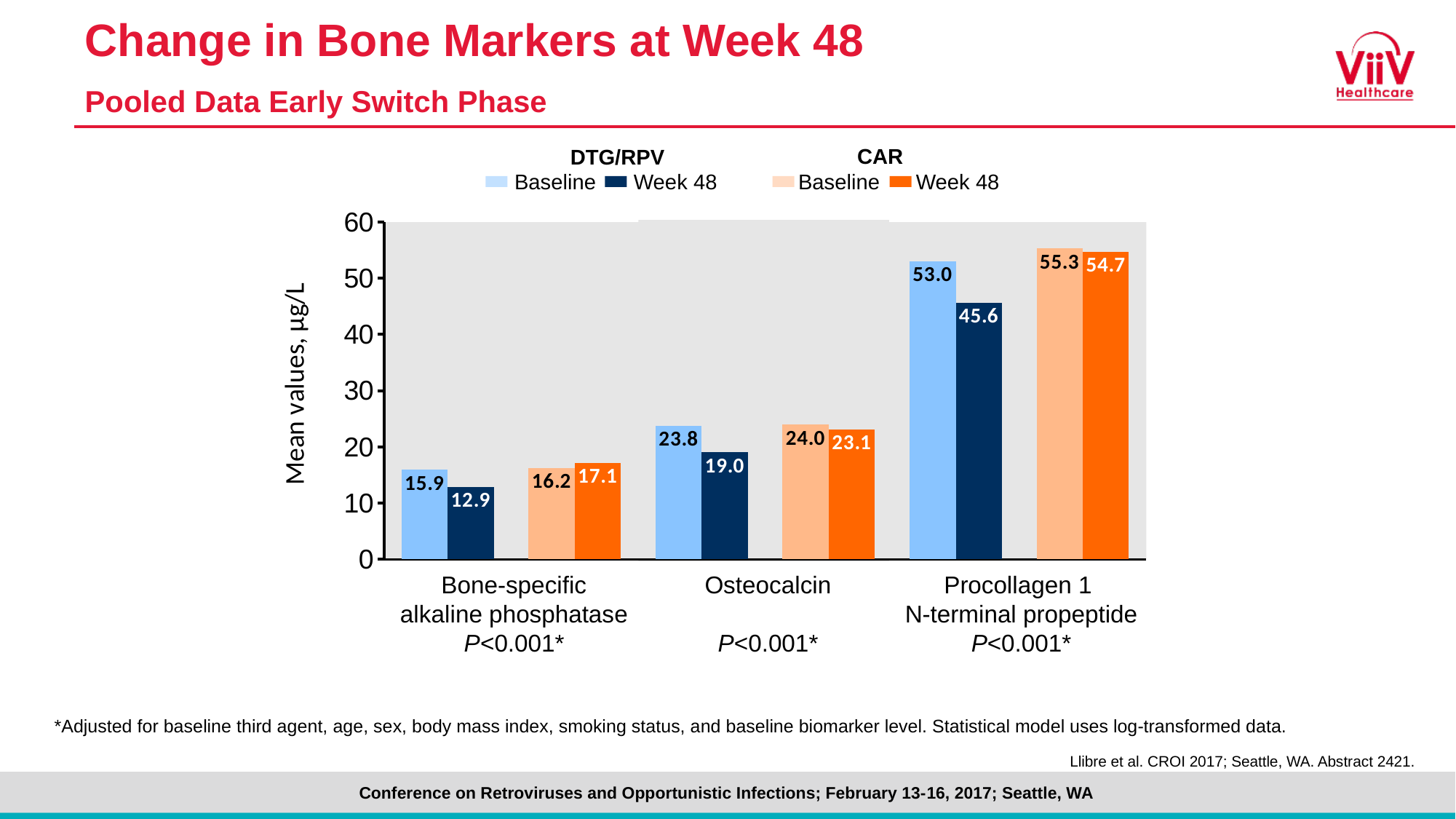
What is the difference between the DTG/RPV Baseline and DTG/RPV Week 48 mean values for Procollagen 1 N-terminal propeptide? 7.4 What is the CAR Week 48 mean value for Bone-specific alkaline phosphatase? 17.1 Which bone marker has the highest DTG/RPV Baseline mean value? Procollagen 1 N-terminal propeptide Which bone marker has the lowest DTG/RPV Week 48 mean value? Bone-specific alkaline phosphatase What is the DTG/RPV Week 48 mean value for Osteocalcin? 19.0 What kind of chart is shown on the slide? Bar chart Is the DTG/RPV Week 48 value for Procollagen 1 N-terminal propeptide greater or less than 50? less What is the DTG/RPV Baseline mean value for Bone-specific alkaline phosphatase? 15.9 How many bone marker categories are shown on the x axis? 3 What is the CAR Baseline mean value for Procollagen 1 N-terminal propeptide? 55.3 For Osteocalcin, which is larger: the DTG/RPV Week 48 value or the CAR Week 48 value? CAR Week 48 How many series does the legend list? 4